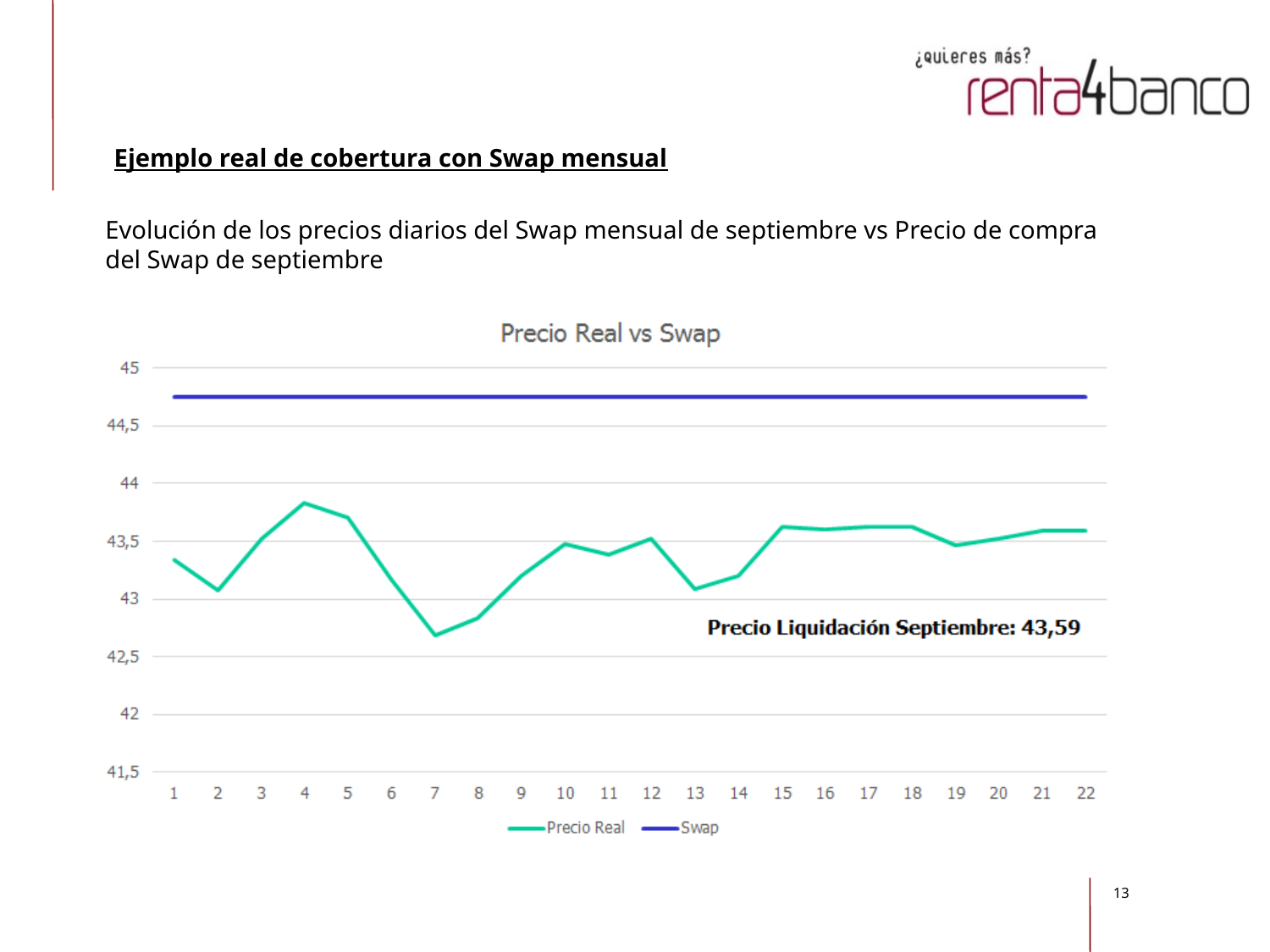
What is the Precio Liquidación Septiembre value printed on the chart? 43,59 What kind of chart is shown on the slide? Line chart What is the title of the chart? Precio Real vs Swap Is the Swap series value greater or less than 44,5? greater How many series does the chart legend list? 2 Is the Precio Real value at point 7 greater or less than 43? less Which series is higher at point 10, Precio Real or Swap? Swap Which two series are listed in the chart legend? Precio Real and Swap How many points are plotted along the x axis for the Precio Real series? 22 Is the Precio Real value at point 4 greater or less than 44? less At which x-axis point does the Precio Real series reach its lowest value? 7 At which x-axis point does the Precio Real series reach its highest value? 4